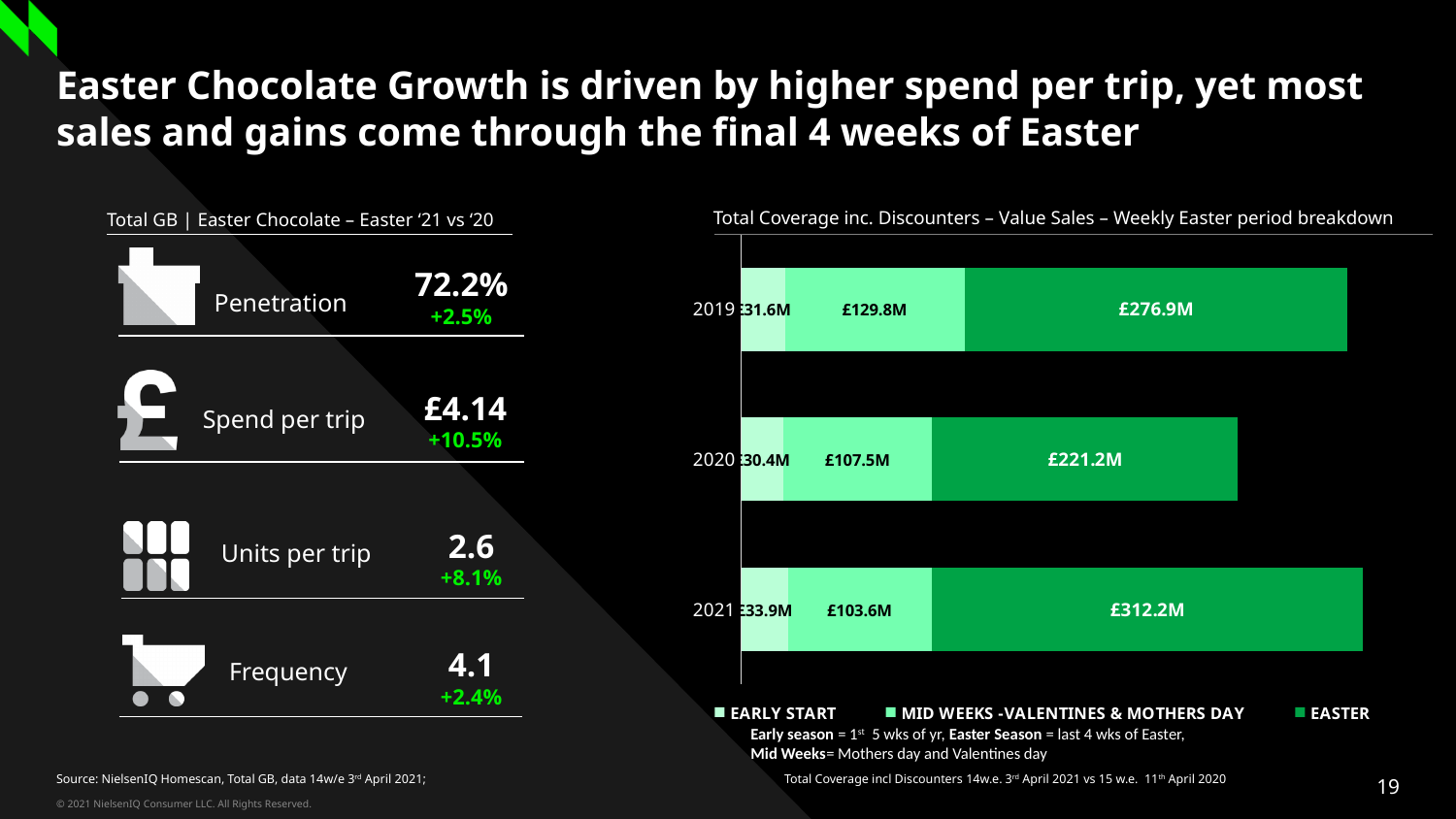
What is the total value sales across all three periods for 2020? £359.1M Which year has the highest Easter value sales? 2021 What is the title of the chart? Total Coverage inc. Discounters – Value Sales – Weekly Easter period breakdown What is the difference between the Easter value in 2021 and in 2020? £91.0M What type of chart is shown on the slide? Stacked bar chart What is the Mid Weeks - Valentines & Mothers Day value for 2019? £129.8M What is the Early Start value for 2020? £30.4M How many series does the chart legend list? 3 How many years are shown on the chart? 3 Which is larger, the Mid Weeks value for 2019 or for 2020? 2019 Which year has the lowest Mid Weeks - Valentines & Mothers Day value? 2021 What is the Easter value sales figure for 2021? £312.2M